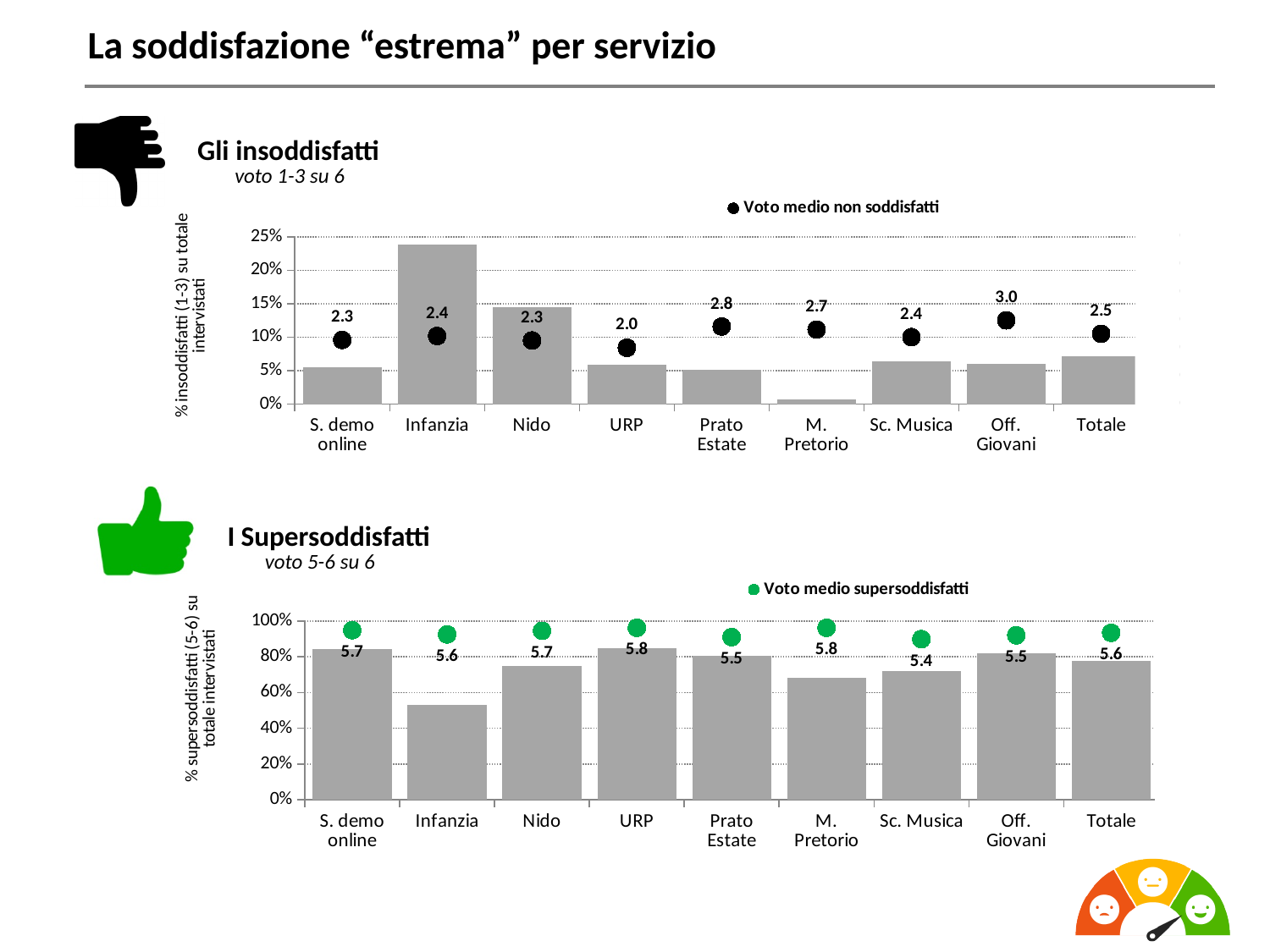
In the 'I Supersoddisfatti' chart, which category has the shortest bar (lowest % supersoddisfatti)? Infanzia In the 'Gli insoddisfatti' chart, what is the difference between the 'Voto medio non soddisfatti' for Off. Giovani and for URP? 1.0 In the 'I Supersoddisfatti' chart, what is the 'Voto medio supersoddisfatti' value for Totale? 5.6 In the 'Gli insoddisfatti' chart, which category has the highest 'Voto medio non soddisfatti'? Off. Giovani In the 'I Supersoddisfatti' chart, is the bar for Infanzia greater or less than 60%? less How many categories are shown on the x axis of the 'I Supersoddisfatti' chart? 9 In the 'Gli insoddisfatti' chart, which category has the shortest bar (lowest % insoddisfatti)? M. Pretorio In the 'Gli insoddisfatti' chart, what is the 'Voto medio non soddisfatti' value for URP? 2.0 In the 'Gli insoddisfatti' chart, what is the 'Voto medio non soddisfatti' value for Off. Giovani? 3.0 In the 'Gli insoddisfatti' chart, is the bar for Infanzia greater or less than 20%? greater In the 'Gli insoddisfatti' chart, which category has the tallest bar (highest % insoddisfatti)? Infanzia In the 'I Supersoddisfatti' chart, what is the 'Voto medio supersoddisfatti' value for Sc. Musica? 5.4